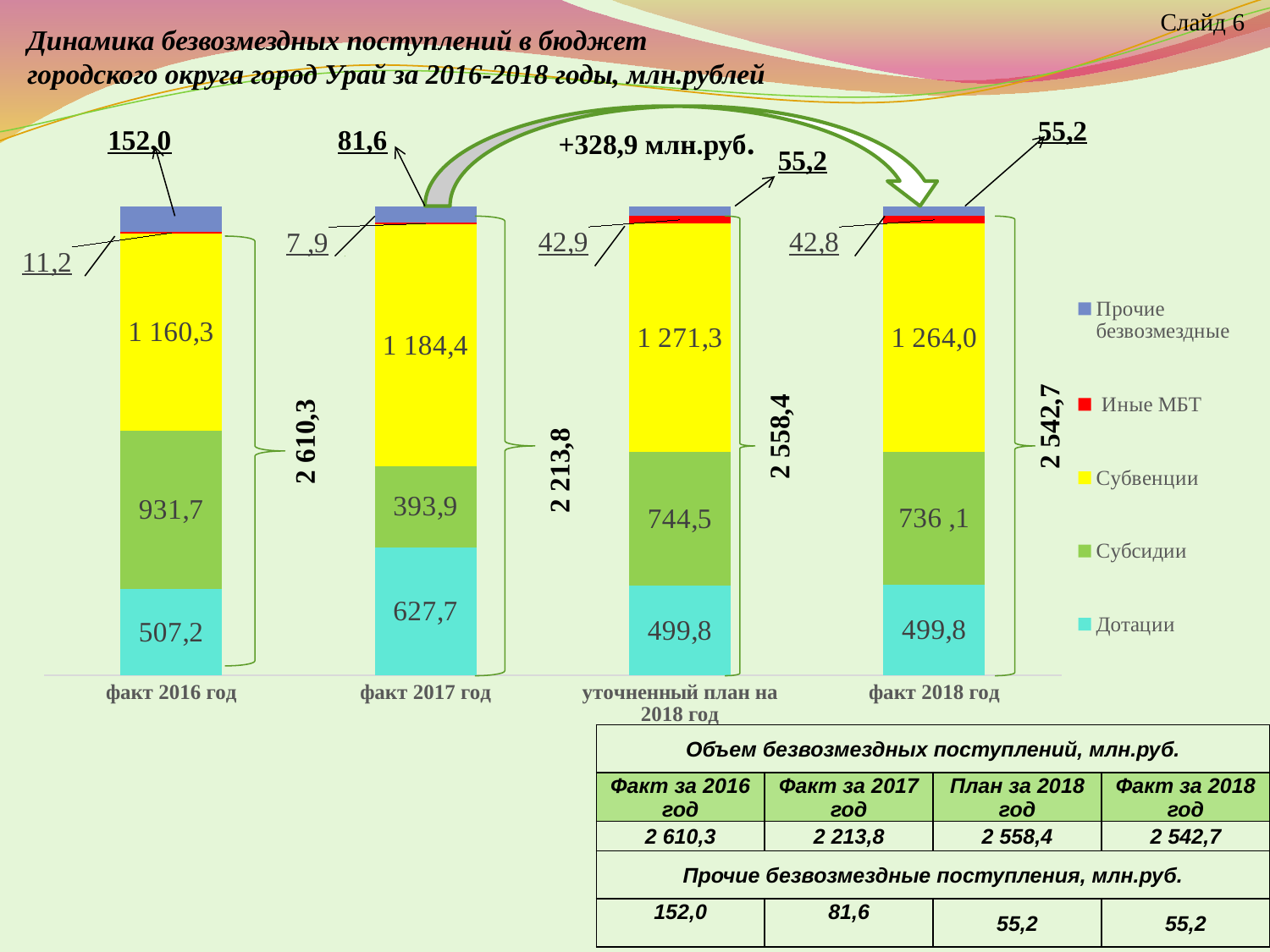
Which category has the highest total of безвозмездные поступления? факт 2016 год How many categories are shown on the x axis? 4 What is the value of Дотации for факт 2017 год? 627,7 Which category has the lowest value of Субсидии? факт 2017 год What is the value of Субвенции for факт 2016 год? 1 160,3 What kind of chart is shown on the slide? stacked bar chart What is the value of Иные МБТ for факт 2018 год? 42,8 Which is larger: Субвенции for уточненный план на 2018 год or for факт 2018 год? уточненный план на 2018 год What is the value of Субсидии for уточненный план на 2018 год? 744,5 What is the total of the stacked bar for факт 2017 год? 2 213,8 What is the difference between Субсидии for факт 2016 год and факт 2017 год? 537,8 How many series does the legend list? 5